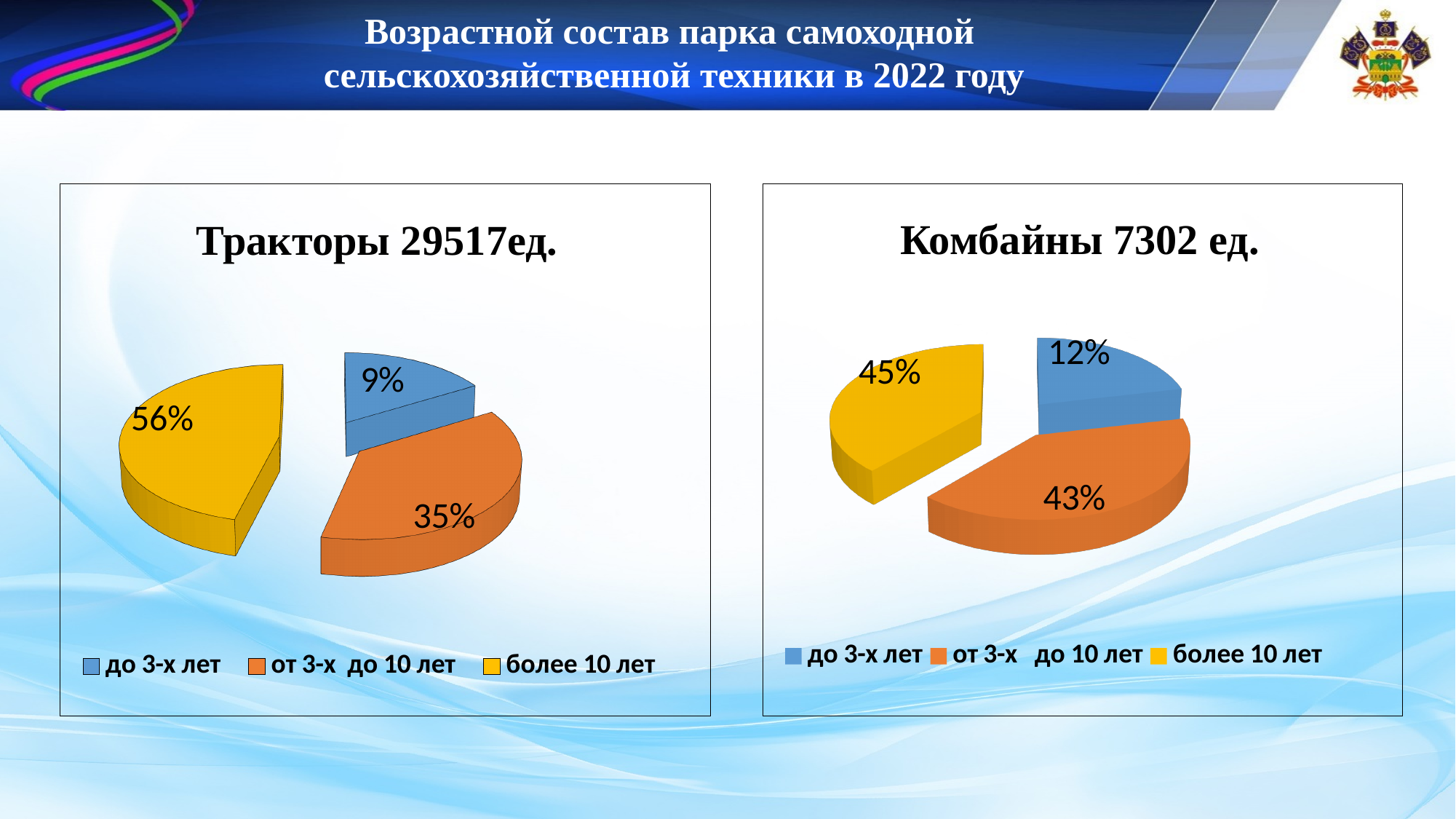
In the chart titled "Комбайны 7302 ед.", what share of the pie is labelled "от 3-х до 10 лет"? 43% In the chart titled "Комбайны 7302 ед.", which category has the smallest slice? до 3-х лет In the chart titled "Тракторы 29517ед.", which category has the largest slice? более 10 лет What type of chart is the chart titled "Тракторы 29517ед."? Pie chart In the chart titled "Тракторы 29517ед.", what is the difference in percentage points between the "более 10 лет" slice and the "от 3-х до 10 лет" slice? 21 How many slices does the pie in the chart titled "Комбайны 7302 ед." have? 3 In the chart titled "Комбайны 7302 ед.", what is the difference in percentage points between the "более 10 лет" slice and the "до 3-х лет" slice? 33 Which is larger: the "до 3-х лет" share in the chart titled "Тракторы 29517ед." or the "до 3-х лет" share in the chart titled "Комбайны 7302 ед."? Комбайны 7302 ед. In the chart titled "Тракторы 29517ед.", what share of the pie is labelled "до 3-х лет"? 9% In the chart titled "Тракторы 29517ед.", what share of the pie is labelled "более 10 лет"? 56% In the chart titled "Тракторы 29517ед.", what colour is the slice for "более 10 лет"? Yellow In the chart titled "Комбайны 7302 ед.", what share of the pie is labelled "до 3-х лет"? 12%